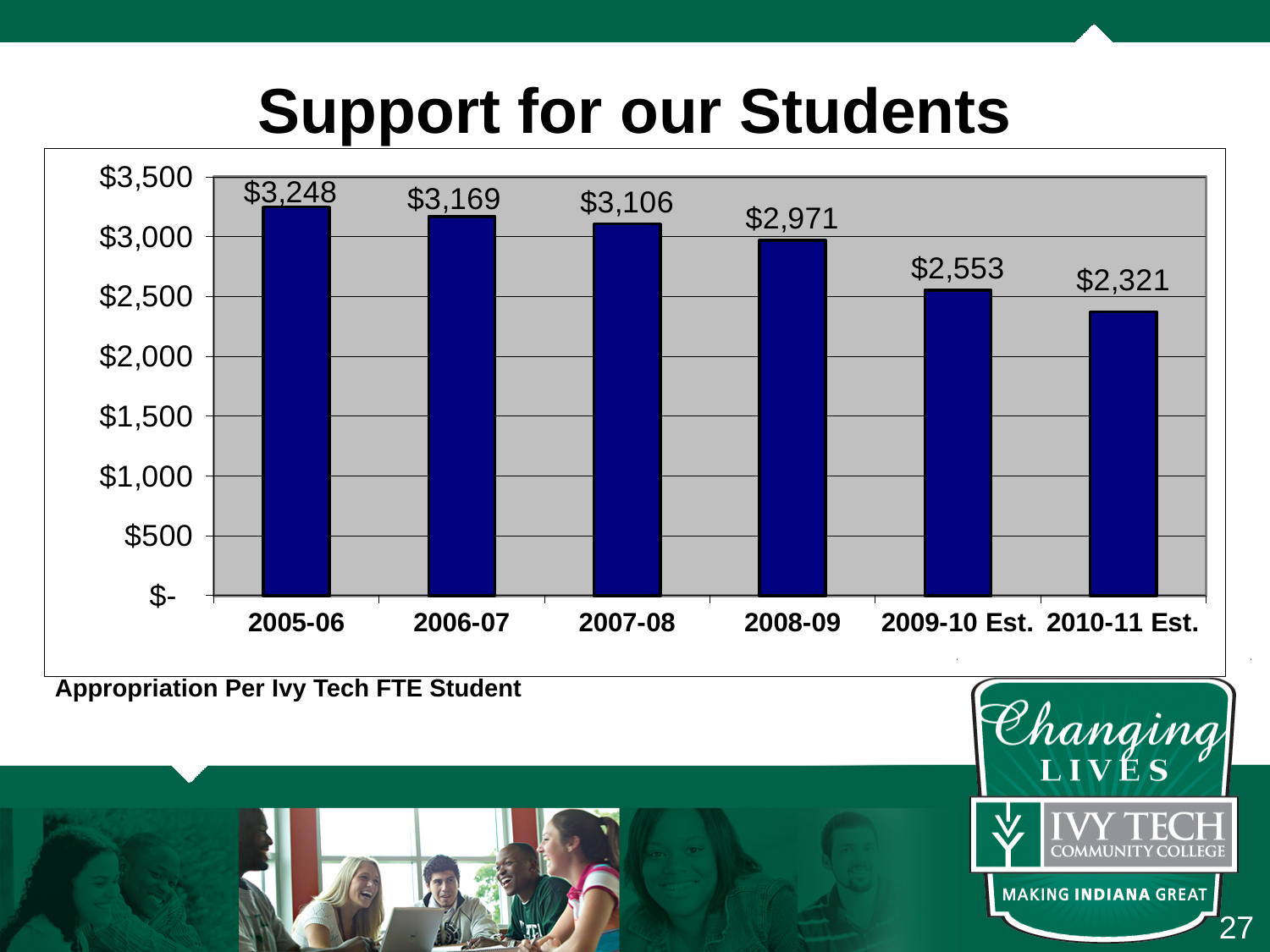
What is the value shown for 2010-11 Est.? $2,321 How many years are shown on the x axis? 6 What kind of chart is shown on the slide? bar chart Which is larger, the value for 2006-07 or the value for 2007-08? 2006-07 Do the values rise or fall from 2005-06 to 2010-11 Est.? fall Which year has the highest appropriation per FTE student? 2005-06 What is the appropriation per Ivy Tech FTE student for 2005-06? $3,248 What is the value shown for 2008-09? $2,971 What is the difference between the 2008-09 value and the 2009-10 Est. value? $418 Which year has the lowest appropriation per FTE student? 2010-11 Est. Is the value for 2009-10 Est. greater or less than $3,000? less What is the difference between the 2005-06 value and the 2010-11 Est. value? $927